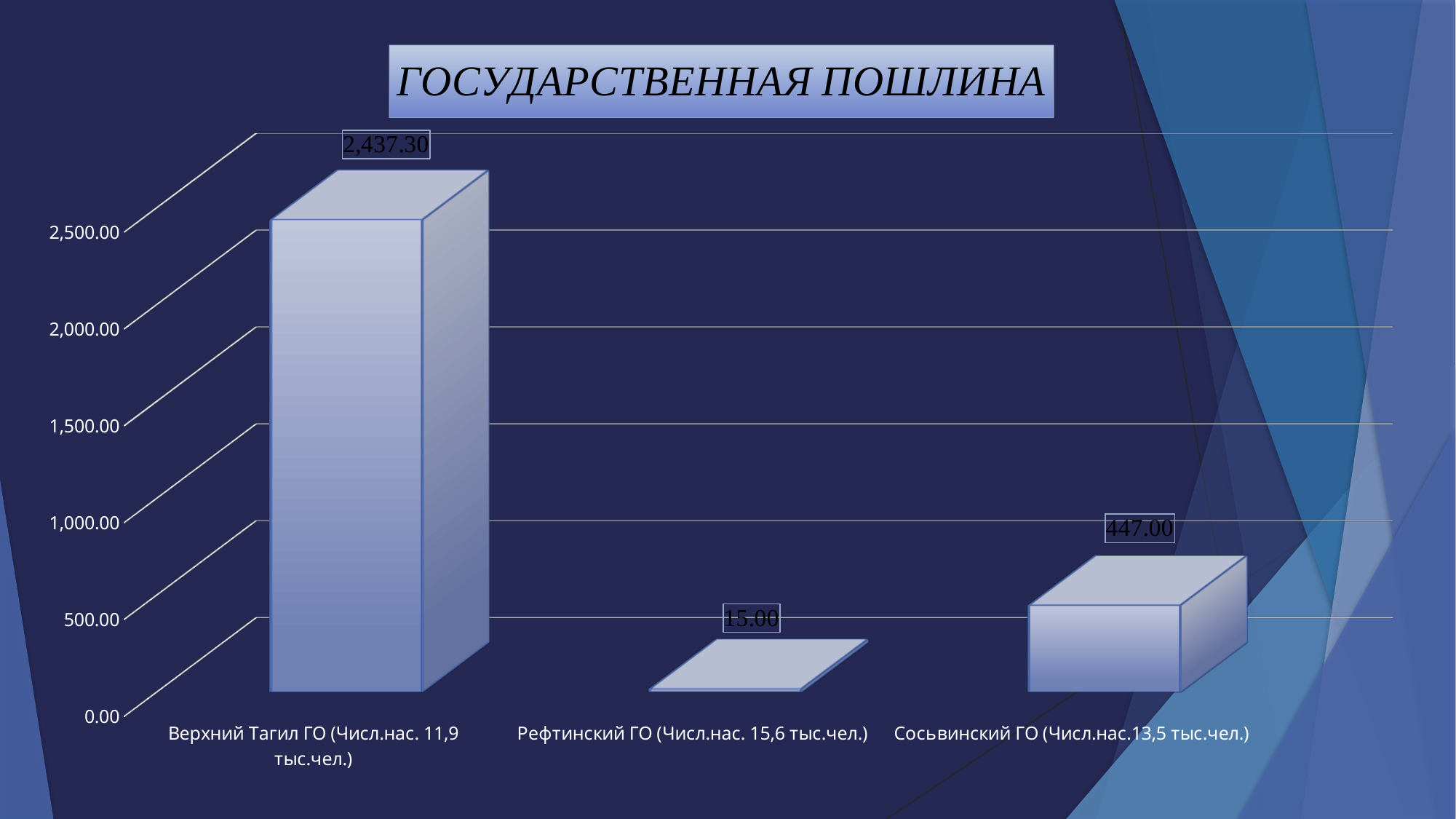
Is the value for Сосьвинский ГО greater or less than 500.00? less What is the title of the chart? ГОСУДАРСТВЕННАЯ ПОШЛИНА Which category has the highest value? Верхний Тагил ГО What kind of chart is shown on the slide? bar chart Which is larger, the value for Сосьвинский ГО or the value for Рефтинский ГО? Сосьвинский ГО What is the value for Верхний Тагил ГО? 2,437.30 How many categories are shown on the chart? 3 What is the value for Сосьвинский ГО? 447.00 Which category has the lowest value? Рефтинский ГО What is the value for Рефтинский ГО? 15.00 What is the difference between the values for Верхний Тагил ГО and Сосьвинский ГО? 1,990.30 What is the difference between the values for Сосьвинский ГО and Рефтинский ГО? 432.00